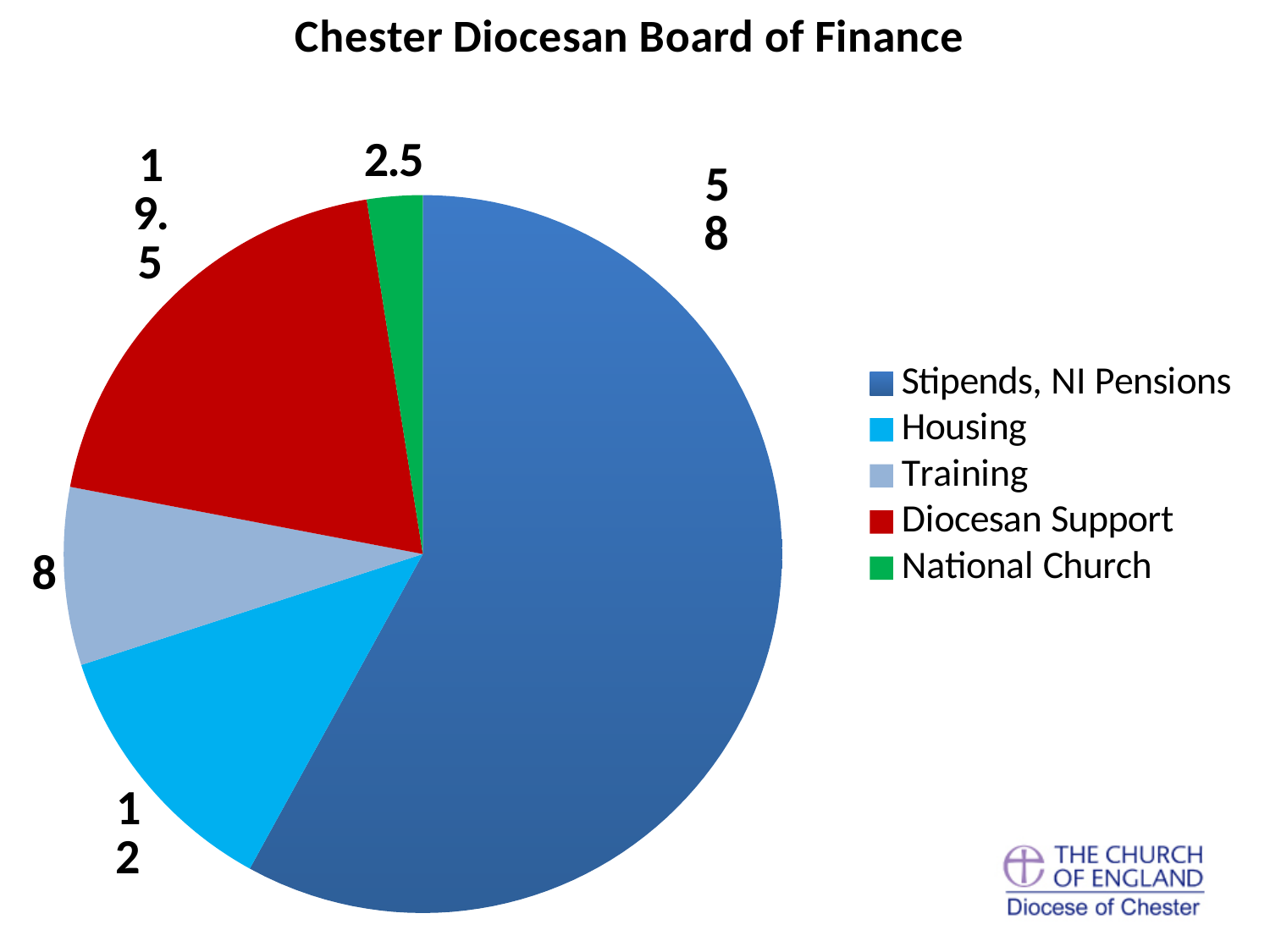
Which is larger, the value for Housing or the value for Training? Housing What type of chart is shown on the slide? Pie chart Which category has the smallest slice of the pie? National Church Which category has the largest slice of the pie? Stipends, NI Pensions How many categories does the legend list? 5 What is the value for Training? 8 What is the value for Stipends, NI Pensions? 58 What is the title of the chart? Chester Diocesan Board of Finance What is the value for Diocesan Support? 19.5 What is the value for National Church? 2.5 What is the value for Housing? 12 What is the difference between the values for Diocesan Support and Housing? 7.5